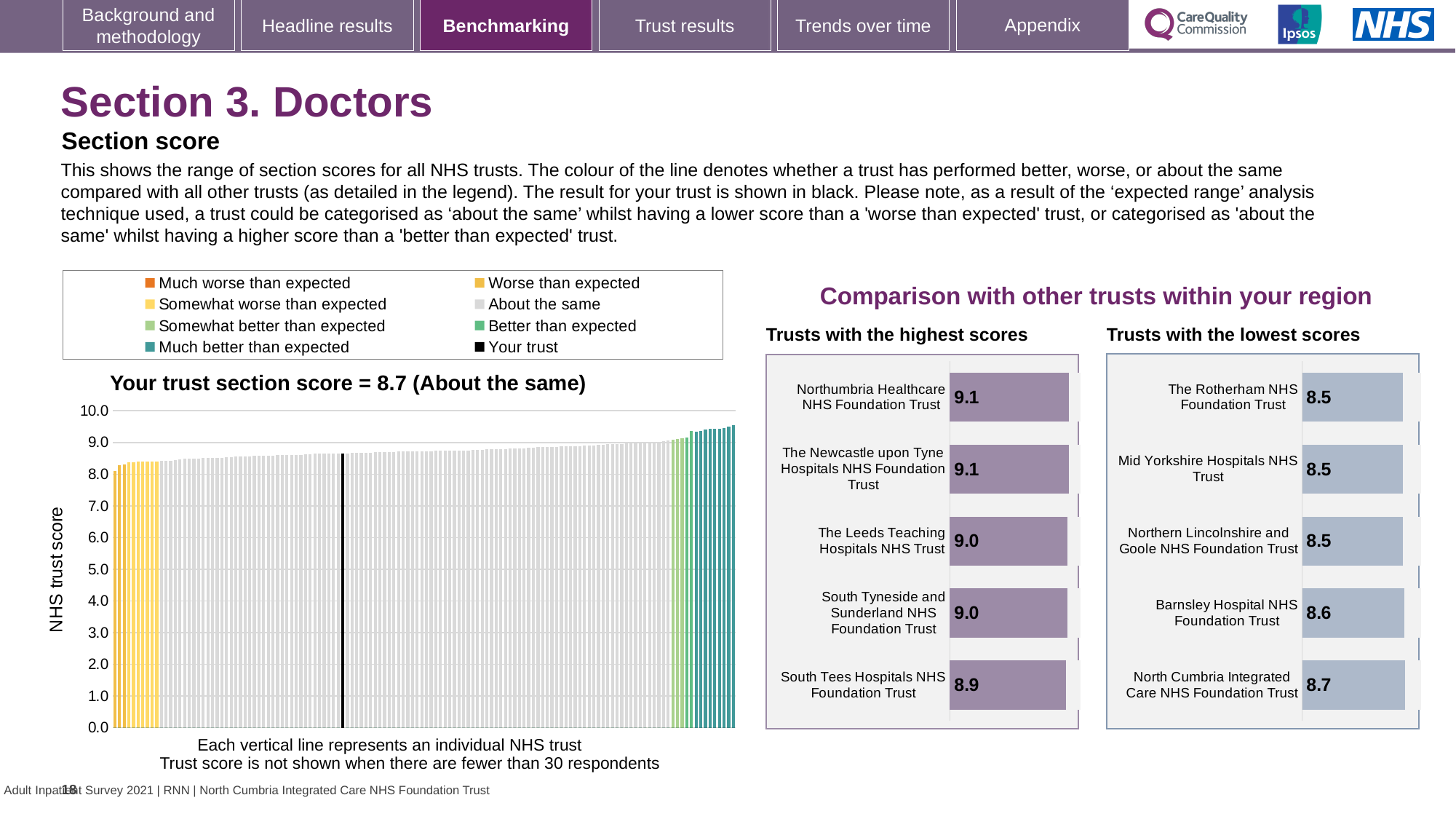
On the 'Trusts with the highest scores' chart, what is the difference between the scores of Northumbria Healthcare NHS Foundation Trust and South Tees Hospitals NHS Foundation Trust? 0.2 On the 'Your trust section score' chart, what kind of chart is shown? bar chart On the 'Your trust section score' chart, is the value of the tallest bar greater or less than 9.0? greater On the 'Trusts with the lowest scores' chart, how many trusts are shown? 5 On the 'Your trust section score' chart, is the value of the shortest bar greater or less than 9.0? less On the 'Your trust section score' chart, what is the section score for your trust? 8.7 On the 'Trusts with the highest scores' chart, which trust has the lowest score? South Tees Hospitals NHS Foundation Trust On the 'Your trust section score' chart, what is the label on the vertical axis? NHS trust score How many entries does the legend above the 'Your trust section score' chart list? 8 On the 'Your trust section score' chart, do the trust scores rise or fall from left to right along the x axis? rise On the 'Trusts with the highest scores' chart, what is the score for The Leeds Teaching Hospitals NHS Trust? 9.0 On the 'Trusts with the lowest scores' chart, which trust has the highest score? North Cumbria Integrated Care NHS Foundation Trust